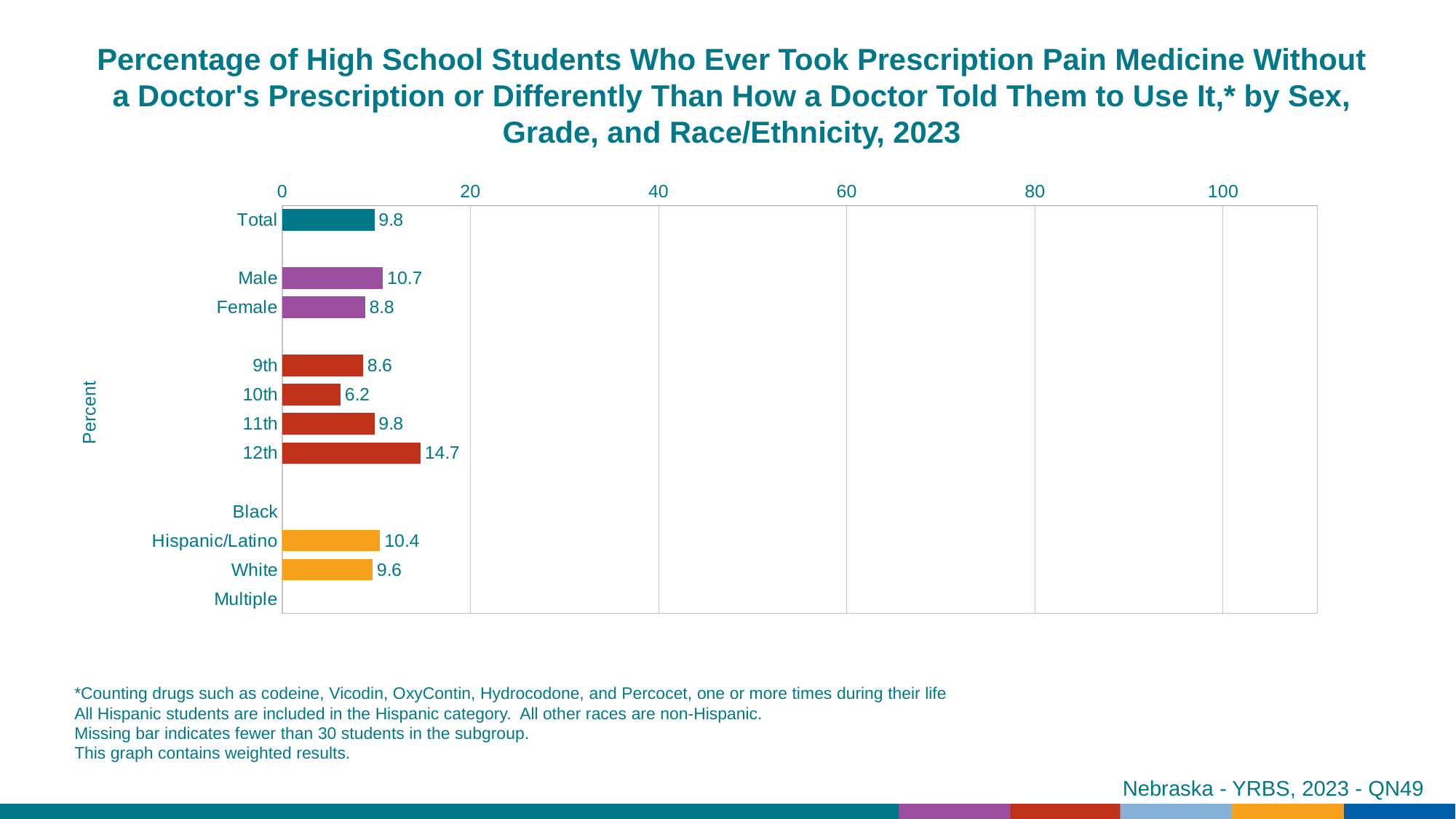
What is the value for Total? 9.8 What is the difference between the Male and Female values? 1.9 Is the value for 12th grade greater or less than 20? less What is the difference between the 12th and 10th grade values? 8.5 What is the value for Hispanic/Latino? 10.4 Which grade has the highest value? 12th What kind of chart is shown on the slide? bar chart Which is larger, the value for Hispanic/Latino or the value for White? Hispanic/Latino What is the value for 12th grade? 14.7 Which grade has the lowest value? 10th Which race/ethnicity categories have no bar shown? Black and Multiple What is the value for Male? 10.7